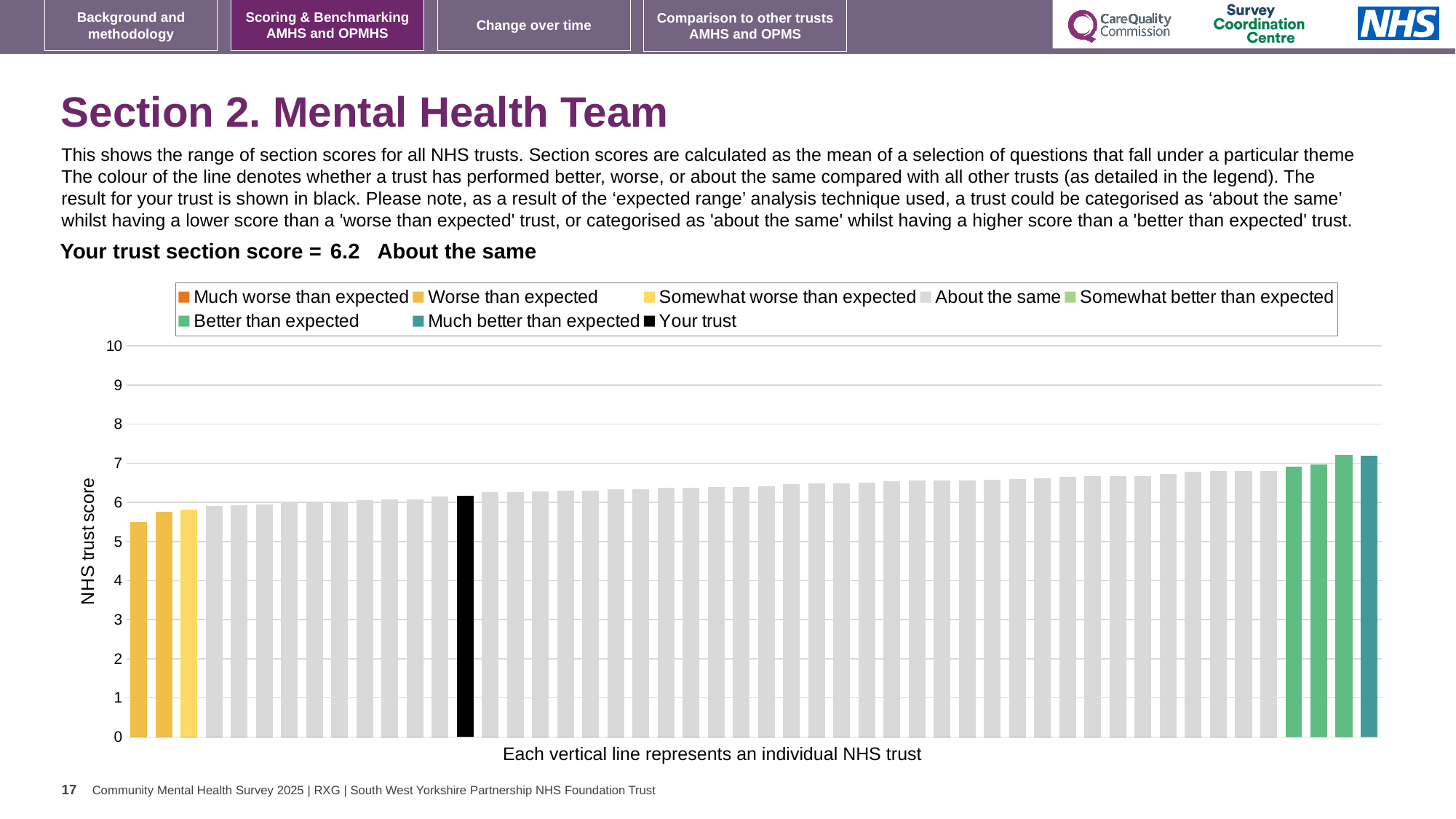
What is the section score for your trust shown on the slide? 6.2 What is the label on the vertical axis of the chart? NHS trust score How many entries does the chart legend list? 8 Is the value of the leftmost bar greater or less than 6? less Do the bar values rise or fall from left to right along the x axis? rise Which category is your trust placed in for this section score? About the same Which is larger: the black bar for your trust or the rightmost bar? the rightmost bar Is the value of the black bar (your trust) greater or less than 5? greater Which is larger: the black bar for your trust or the leftmost bar? the black bar for your trust What colour is used in the legend for 'Your trust'? black What kind of chart is shown on the slide? bar chart Is the value of the rightmost bar greater or less than 6? greater